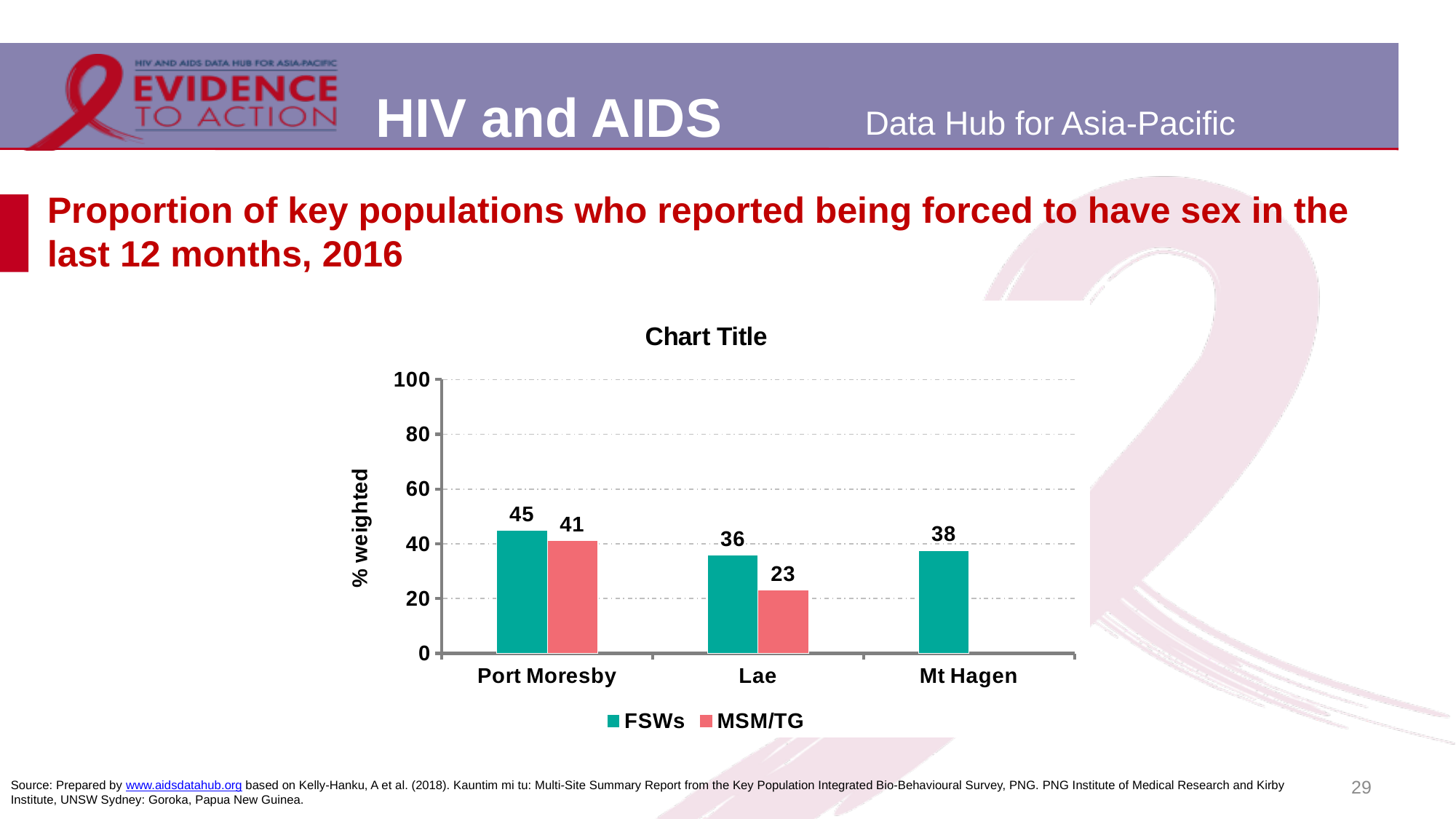
What kind of chart is shown on the slide? bar chart What is the value for FSWs in Mt Hagen? 38 What is the value for MSM/TG in Lae? 23 How many cities are shown on the x axis? 3 Which is larger in Port Moresby, the FSWs value or the MSM/TG value? FSWs Which city has the highest value for FSWs? Port Moresby How many series does the legend list? 2 What is the value for FSWs in Port Moresby? 45 Which city has the lowest value for FSWs? Lae What is the value for MSM/TG in Port Moresby? 41 Is the value for FSWs in Lae greater or less than 40? less What is the difference between the FSWs and MSM/TG values in Lae? 13